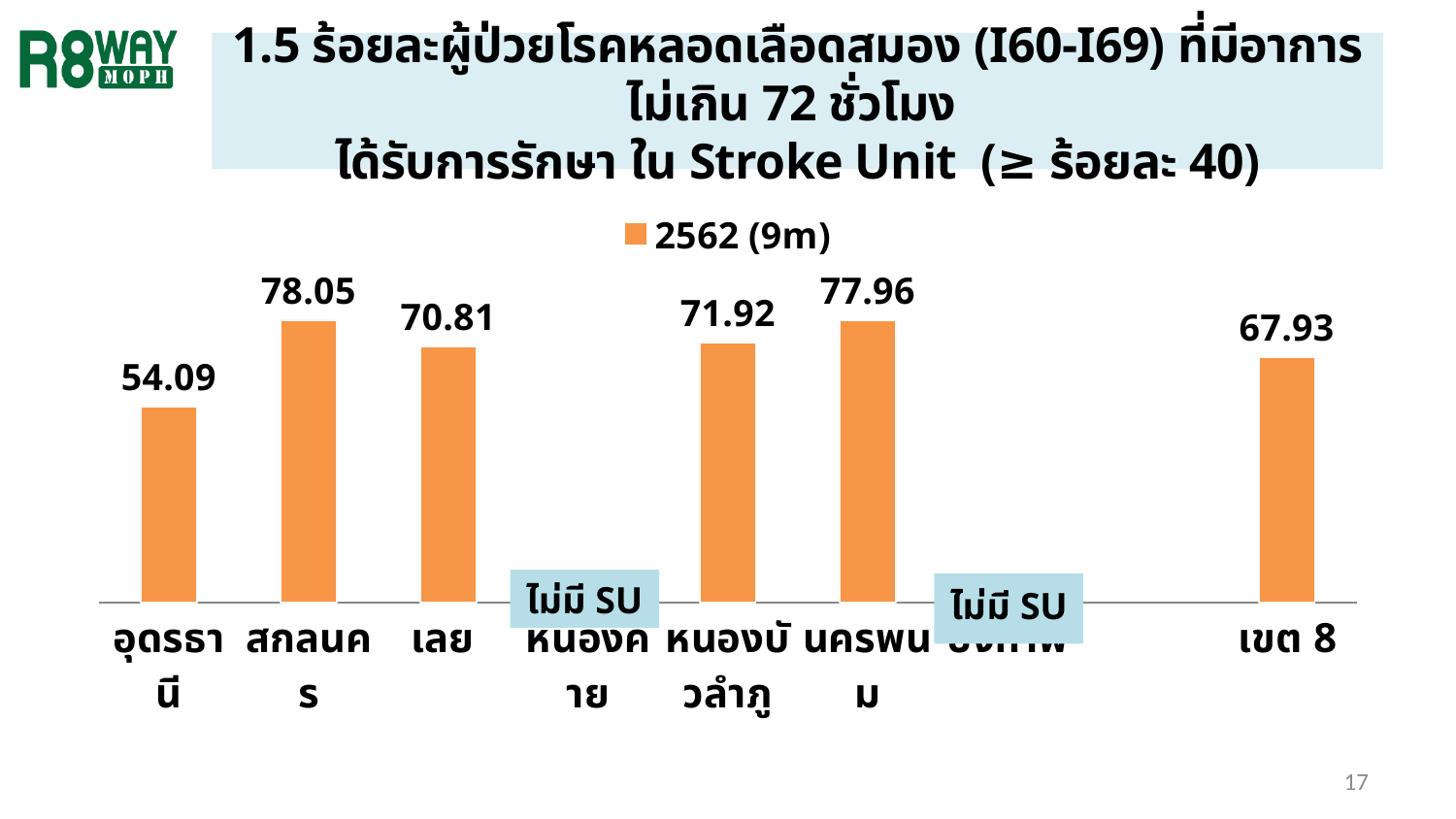
Which province has the lowest value? อุดรธานี What is the value for สกลนคร? 78.05 What is the value for อุดรธานี? 54.09 What is the value for เลย? 70.81 How many series does the legend list? 1 Which category has the highest value? สกลนคร What is the value for เขต 8? 67.93 What kind of chart is shown on the slide? bar chart What is the value for หนองบัวลำภู? 71.92 Which is larger, the value for เลย or the value for เขต 8? เลย What is the value for นครพนม? 77.96 What is the difference between the values for สกลนคร and อุดรธานี? 23.96